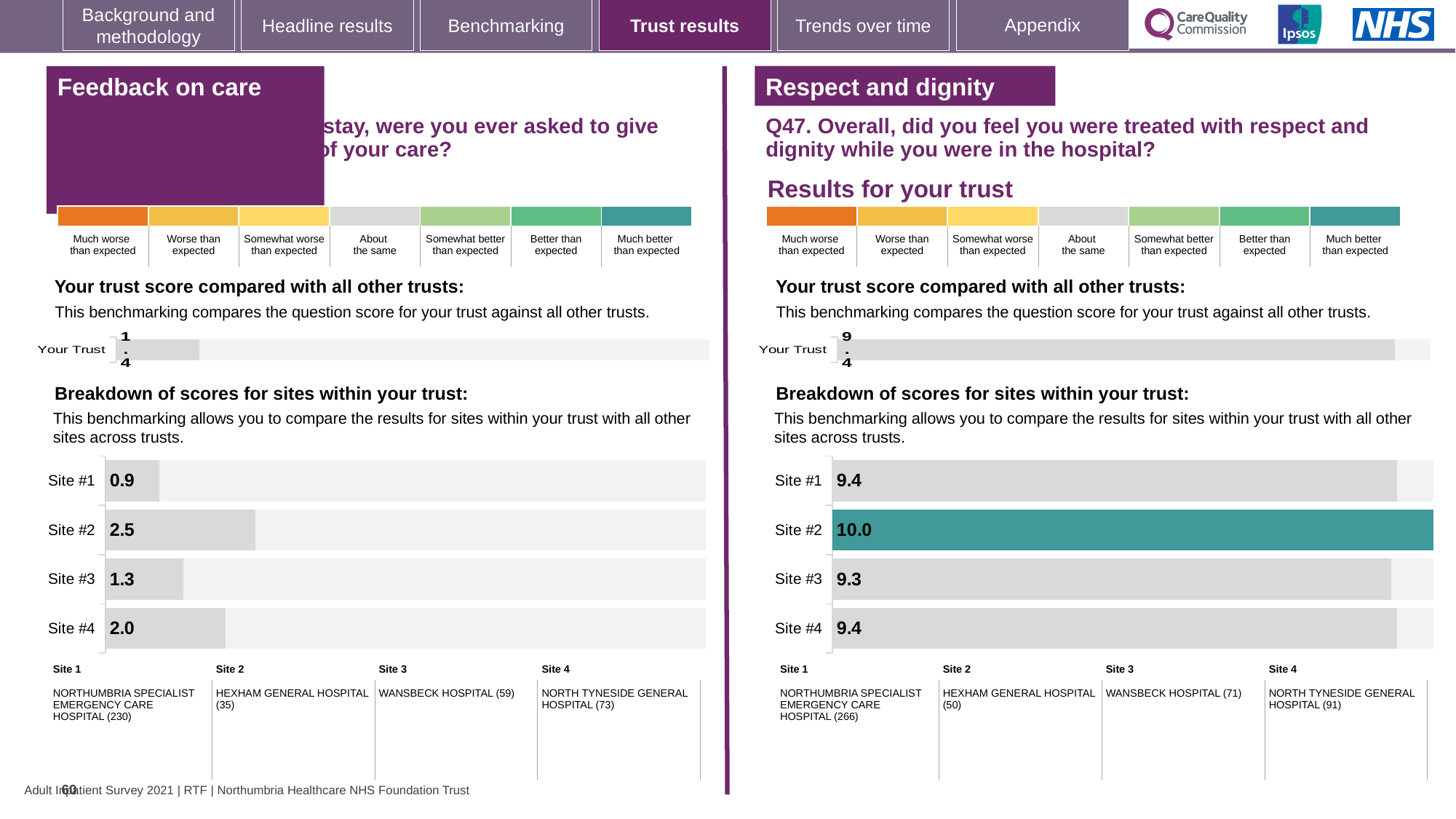
In the 'Feedback on care' site breakdown chart on the left, which site has the lowest score? Site #1 How many sites are shown in the 'Respect and dignity' site breakdown chart on the right? 4 What type of chart is used for the site breakdown on the left 'Feedback on care' panel? Bar chart In the 'Respect and dignity' site breakdown chart on the right, what is the difference between the scores for Site #2 and Site #3? 0.7 In the 'Feedback on care' site breakdown chart on the left, which has the larger score, Site #3 or Site #4? Site #4 In the 'Respect and dignity' site breakdown chart on the right, which site has the lowest score? Site #3 In the 'Your Trust' chart on the right 'Respect and dignity' panel, what is the trust score? 9.4 In the 'Respect and dignity' site breakdown chart on the right, which site has the highest score? Site #2 In the 'Feedback on care' site breakdown chart on the left, what is the score for Site #2? 2.5 In the 'Feedback on care' site breakdown chart on the left, which site has the highest score? Site #2 In the 'Feedback on care' site breakdown chart on the left, what is the difference between the scores for Site #2 and Site #1? 1.6 In the 'Respect and dignity' site breakdown chart on the right, what is the score for Site #3? 9.3